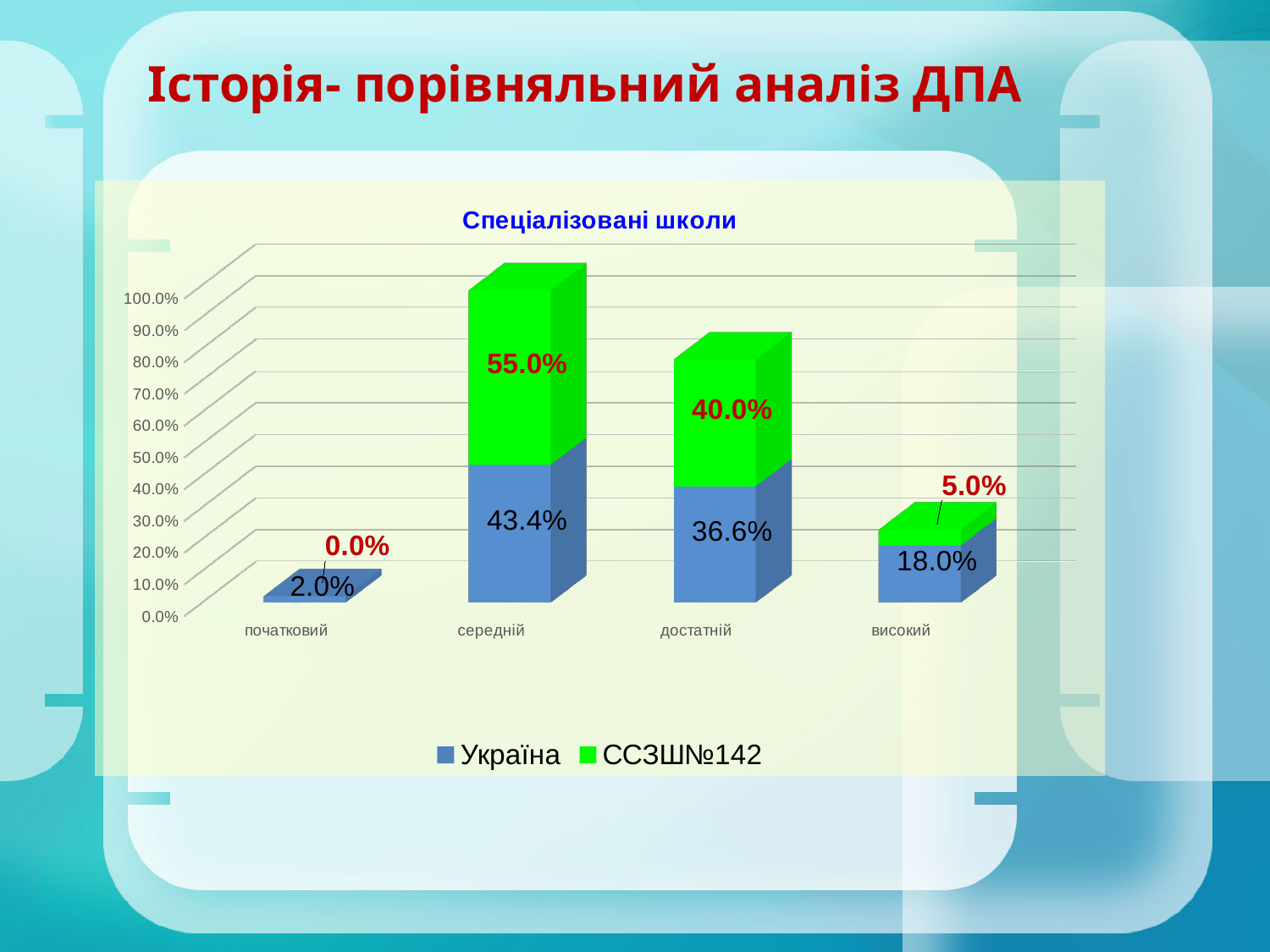
In the високий category, which series has the larger value, Україна or ССЗШ№142? Україна How many categories are shown on the x axis? 4 What is the value for ССЗШ№142 in the достатній category? 40.0% What is the total of the stacked bar for the достатній category? 76.6% How many series does the legend list? 2 What kind of chart is shown on the slide? Stacked bar chart What is the value for Україна in the високий category? 18.0% What is the difference between the ССЗШ№142 and Україна values in the середній category? 11.6% What is the value for ССЗШ№142 in the початковий category? 0.0% What is the value for Україна in the середній category? 43.4% Which category has the lowest value for Україна? початковий Which category has the highest value for ССЗШ№142? середній